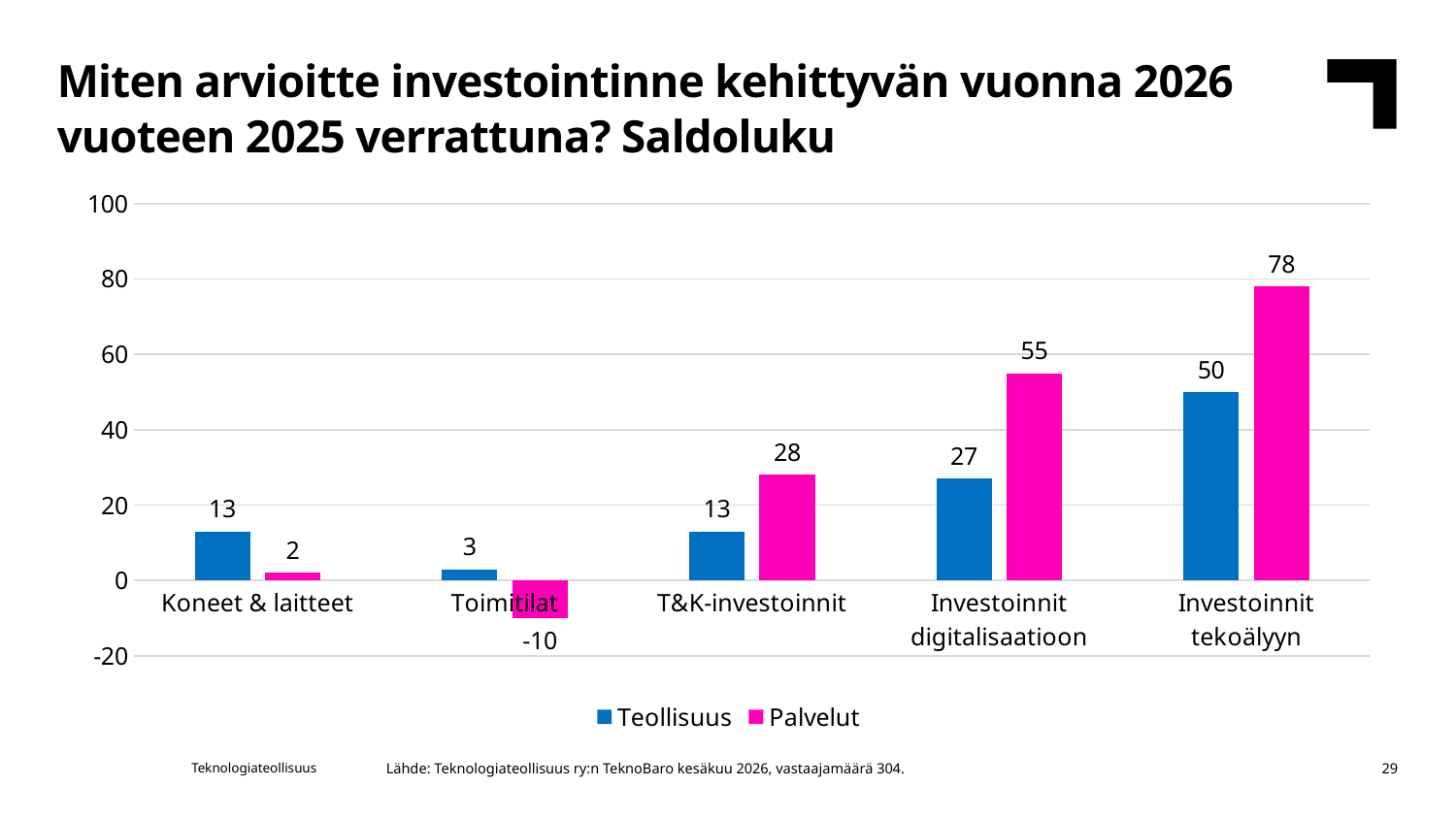
What kind of chart is shown on the slide? Bar chart Is the Palvelut value for Investoinnit digitalisaatioon greater or less than 40? greater Which is larger for Koneet & laitteet: the Teollisuus value or the Palvelut value? Teollisuus What is the value for Palvelut in the Toimitilat category? -10 Which colour represents the Palvelut series? Magenta (pink) How many series does the legend list? 2 What is the value for Teollisuus in the Investoinnit digitalisaatioon category? 27 What is the difference between the Palvelut and Teollisuus values for Investoinnit tekoälyyn? 28 Which category has the lowest Teollisuus value? Toimitilat How many categories are shown on the x axis? 5 What is the value for Palvelut in the Investoinnit tekoälyyn category? 78 Which category has the highest Palvelut value? Investoinnit tekoälyyn